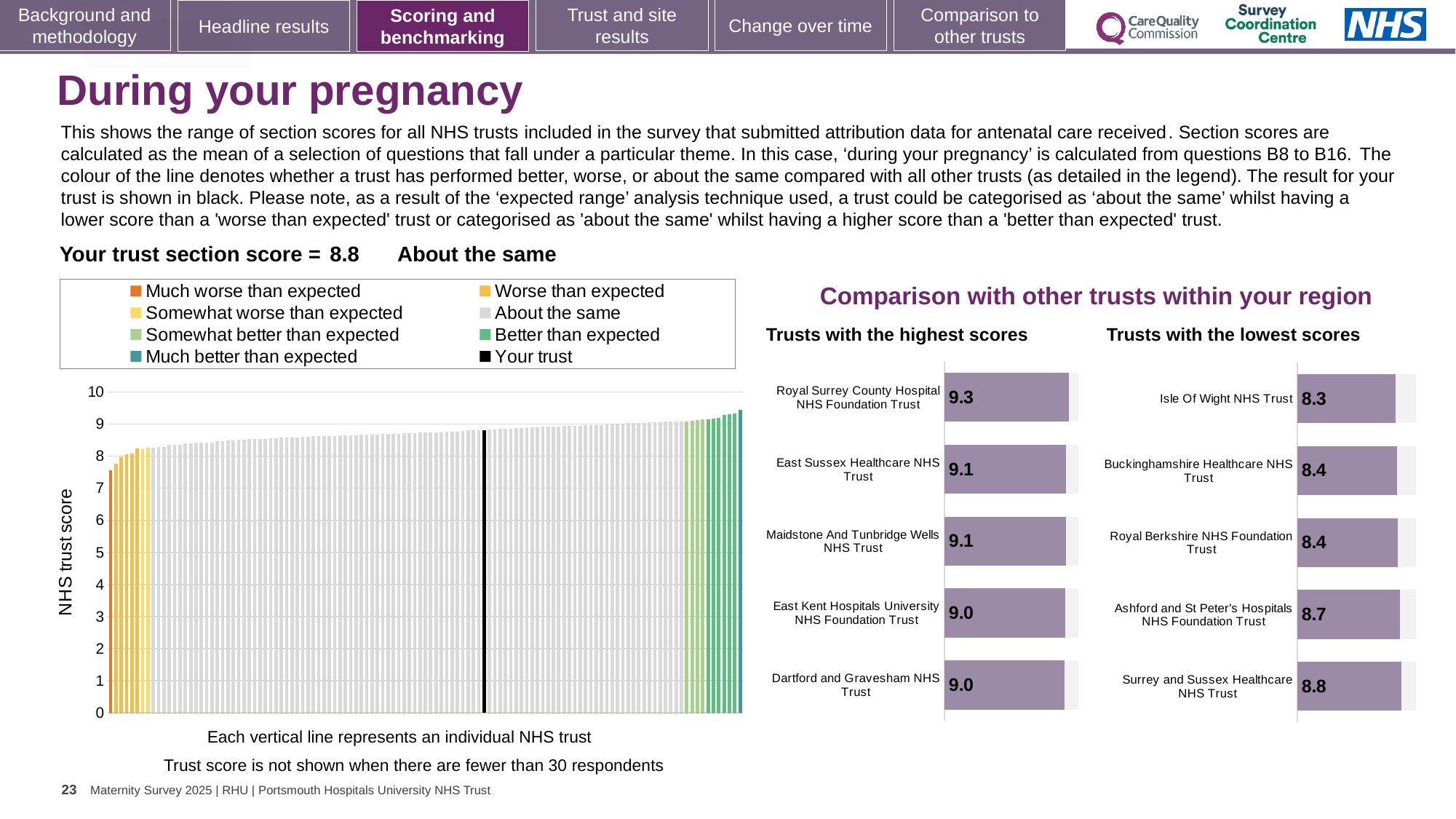
In the 'Trusts with the lowest scores' chart, which has the higher score: Ashford and St Peter's Hospitals NHS Foundation Trust or Buckinghamshire Healthcare NHS Trust? Ashford and St Peter's Hospitals NHS Foundation Trust What kind of chart is the large 'NHS trust score' chart on the left of the slide? Bar chart In the 'Trusts with the lowest scores' chart, which trust has the lowest score? Isle Of Wight NHS Trust In the 'Trusts with the lowest scores' chart, what is the score for Isle Of Wight NHS Trust? 8.3 In the 'Trusts with the highest scores' chart, what is the score for Royal Surrey County Hospital NHS Foundation Trust? 9.3 In the large 'NHS trust score' chart on the left, is the value for the black 'Your trust' line greater or less than 8? greater In the 'Trusts with the lowest scores' chart, what is the score for Surrey and Sussex Healthcare NHS Trust? 8.8 In the 'Trusts with the highest scores' chart, what is the difference between the scores of Royal Surrey County Hospital NHS Foundation Trust and Dartford and Gravesham NHS Trust? 0.3 How many entries does the legend above the large 'NHS trust score' chart list? 8 In the 'Trusts with the highest scores' chart, which trust has the highest score? Royal Surrey County Hospital NHS Foundation Trust How many trusts are shown in the 'Trusts with the highest scores' chart? 5 In the large 'NHS trust score' chart on the left, do the values rise or fall from left to right? Rise